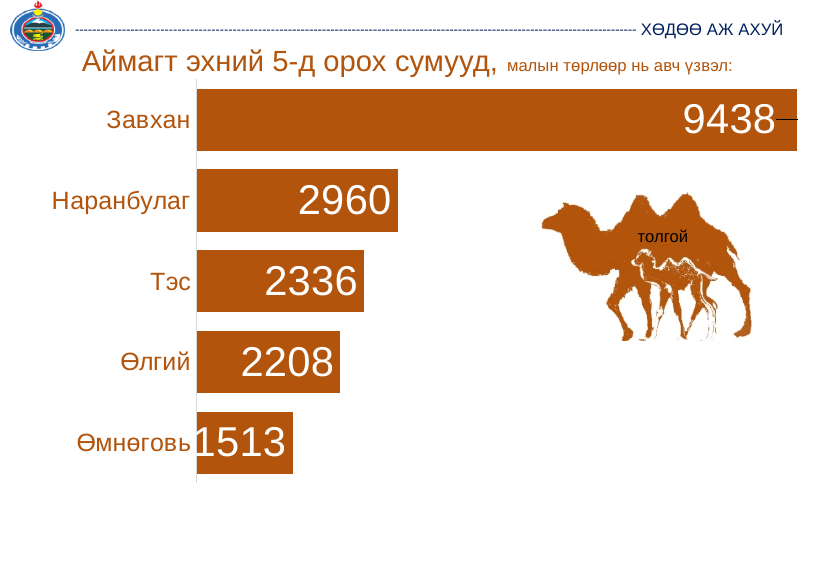
Which is larger, the value for Наранбулаг or the value for Өмнөговь? Наранбулаг What is the value for Тэс? 2336 What kind of chart is shown on the slide? Bar chart Which category has the lowest value? Өмнөговь What is the value for Наранбулаг? 2960 What is the difference between the values for Завхан and Наранбулаг? 6478 What is the value for Өмнөговь? 1513 How many categories are shown in the chart? 5 What is the difference between the values for Тэс and Өлгий? 128 What is the value for Өлгий? 2208 What is the value for Завхан? 9438 Which category has the highest value? Завхан